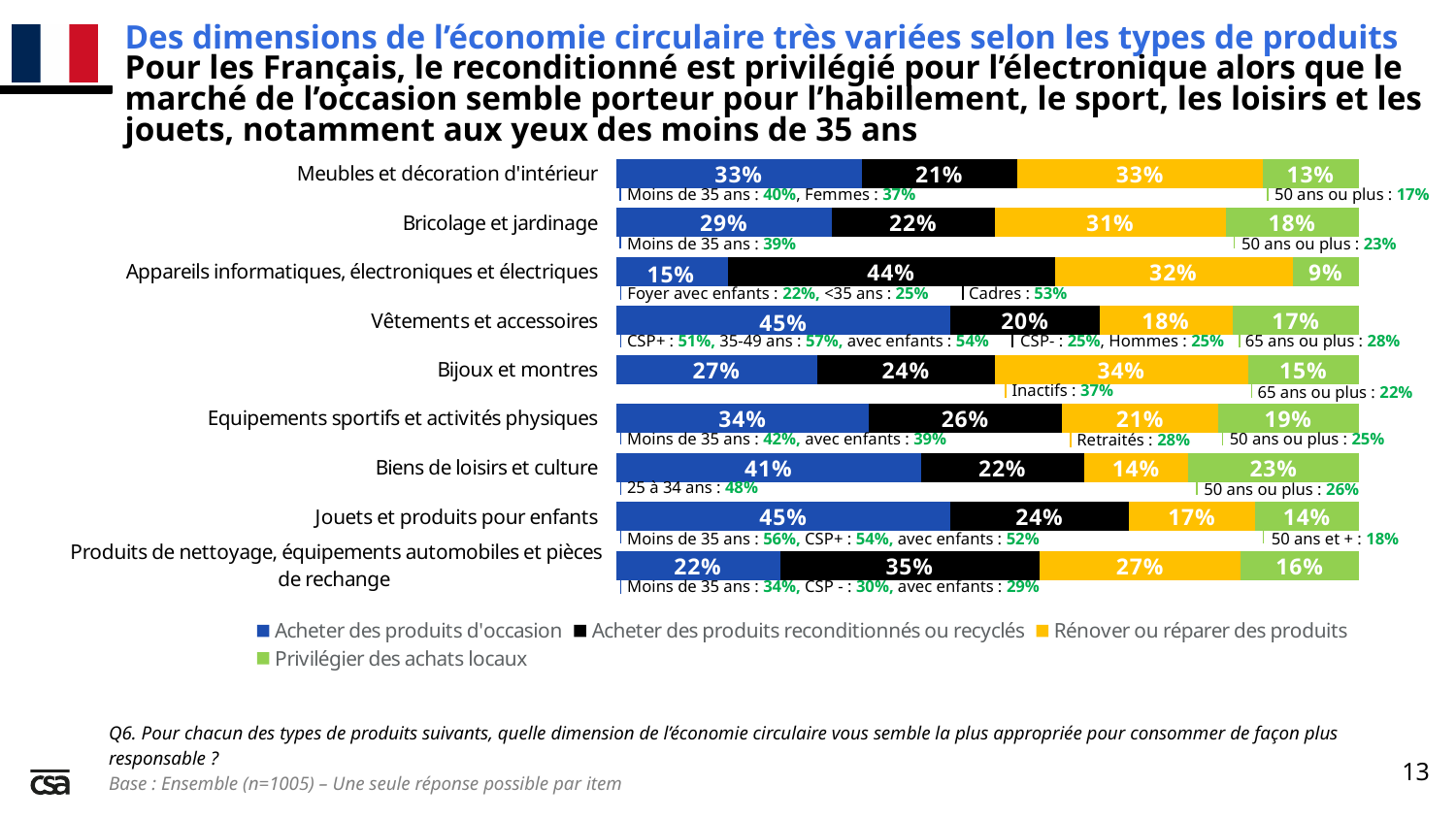
Which is larger for "Bijoux et montres": "Rénover ou réparer des produits" or "Acheter des produits d'occasion"? Rénover ou réparer des produits What is the value of "Privilégier des achats locaux" for "Biens de loisirs et culture"? 23% Which category has the lowest value for "Privilégier des achats locaux"? Appareils informatiques, électroniques et électriques What is the total of the stacked bar for "Vêtements et accessoires"? 100% How many product categories are plotted in the chart? 9 What is the value of "Acheter des produits d'occasion" for "Jouets et produits pour enfants"? 45% Which category has the lowest value for "Acheter des produits d'occasion"? Appareils informatiques, électroniques et électriques What kind of chart is shown on the slide? Stacked bar chart For "Appareils informatiques, électroniques et électriques", what is the difference between "Acheter des produits reconditionnés ou recyclés" and "Acheter des produits d'occasion"? 29 points What is the value of "Acheter des produits reconditionnés ou recyclés" for "Appareils informatiques, électroniques et électriques"? 44% How many series does the legend list? 4 Which category has the highest value for "Acheter des produits reconditionnés ou recyclés"? Appareils informatiques, électroniques et électriques